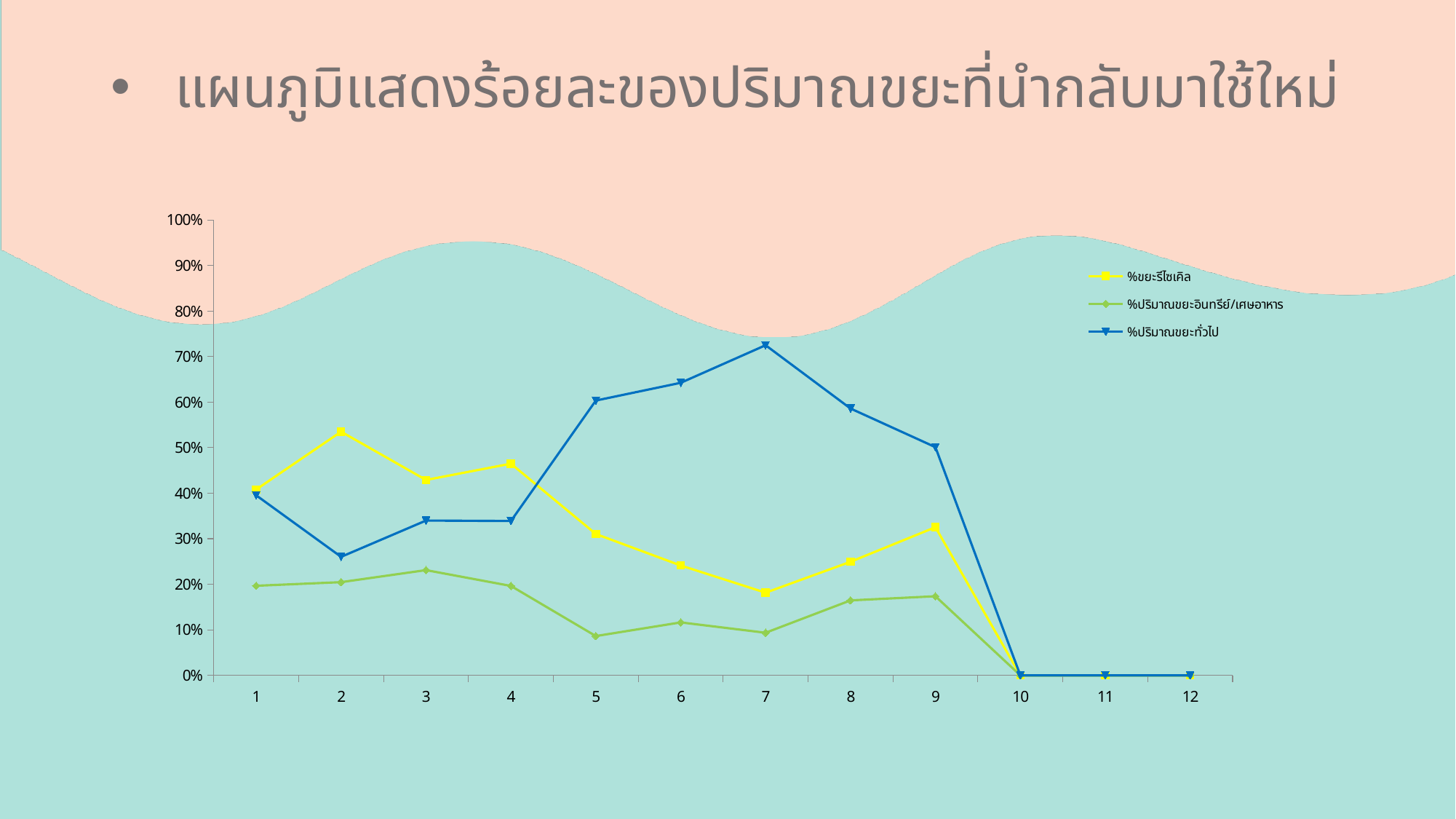
At which x value does %ปริมาณขยะทั่วไป reach its highest point? 7 What is the value of %ปริมาณขยะทั่วไป at x = 12? 0% Is the value for %ปริมาณขยะทั่วไป at x = 7 greater or less than 60%? greater How many series does the legend list? 3 At which x value does %ขยะรีไซเคิล reach its highest point? 2 At x = 2, which is larger: %ขยะรีไซเคิล or %ปริมาณขยะทั่วไป? %ขยะรีไซเคิล Does %ขยะรีไซเคิล rise or fall from x = 4 to x = 7? fall What kind of chart is shown on the slide? line chart What is the value of %ขยะรีไซเคิล at x = 10? 0% Is the value for %ขยะรีไซเคิล at x = 2 greater or less than 50%? greater Is the value for %ปริมาณขยะอินทรีย์/เศษอาหาร at x = 5 greater or less than 10%? less How many points are on the x axis of the chart? 12